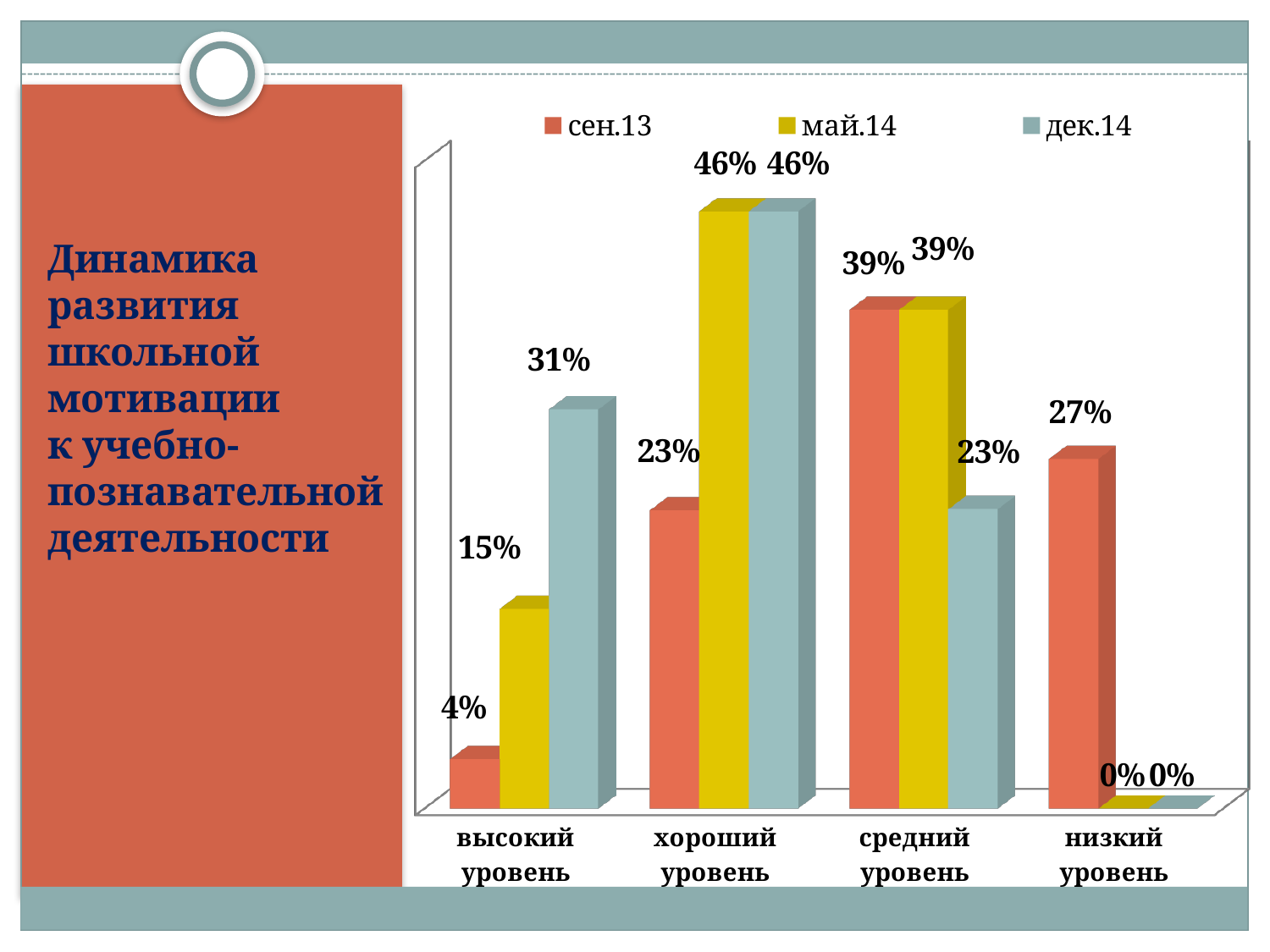
What is the value for дек.14 at средний уровень? 23% What is the value for дек.14 at высокий уровень? 31% What is the value for май.14 at хороший уровень? 46% Which category has the highest value for the сен.13 series? средний уровень What is the value for сен.13 at высокий уровень? 4% How many categories are shown on the x axis? 4 Which is larger at средний уровень: the май.14 value or the дек.14 value? май.14 What is the difference between the дек.14 and сен.13 values at высокий уровень? 27% What kind of chart is shown on the slide? bar chart How many series does the legend list? 3 Which category has the lowest value for the дек.14 series? низкий уровень What is the value for сен.13 at низкий уровень? 27%